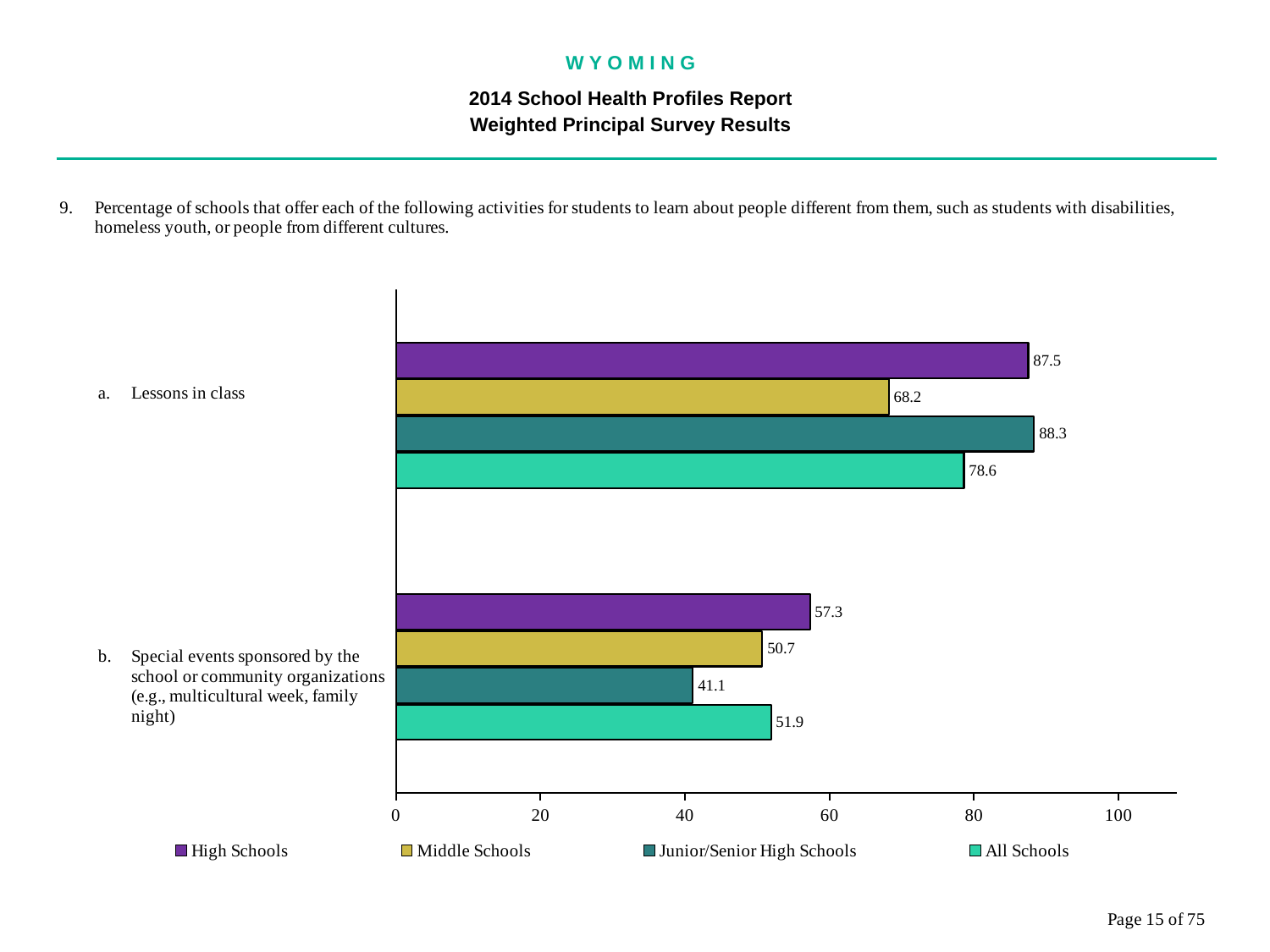
Which school type has the highest value for "Lessons in class"? Junior/Senior High Schools What is the difference between the High Schools values for "Lessons in class" and "Special events sponsored by the school or community organizations"? 30.2 Is the value for Junior/Senior High Schools for "Special events sponsored by the school or community organizations" greater or less than 60? less How many activity categories are shown in the chart? 2 What is the value for All Schools for "Lessons in class"? 78.6 What kind of chart is shown on the slide? bar chart How many series does the legend list? 4 Which legend entry is shown in purple? High Schools What is the value for High Schools for "Lessons in class"? 87.5 Which is larger for "Special events sponsored by the school or community organizations": the value for All Schools or the value for Middle Schools? All Schools What is the value for Middle Schools for "Special events sponsored by the school or community organizations"? 50.7 Which school type has the lowest value for "Special events sponsored by the school or community organizations"? Junior/Senior High Schools